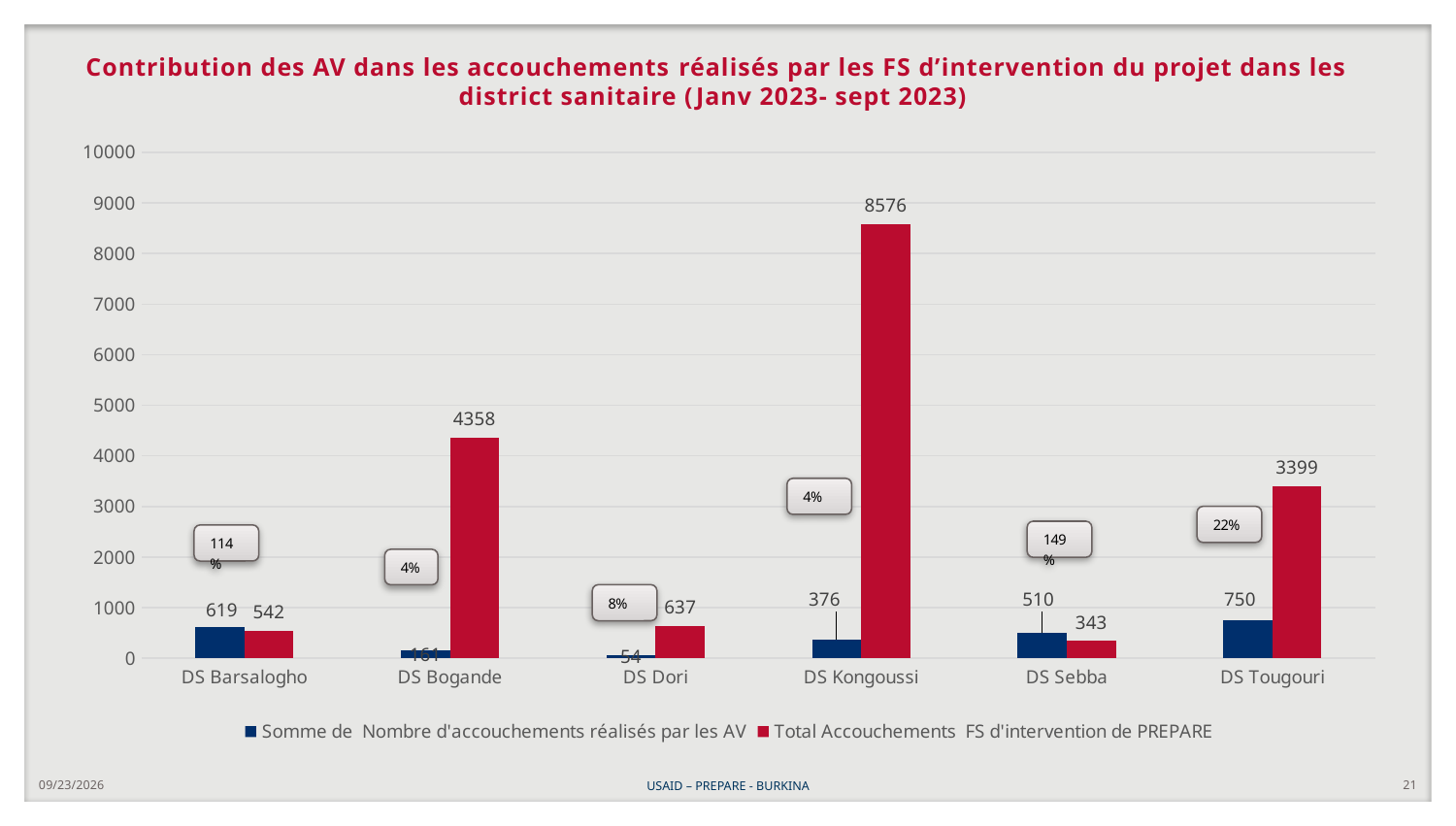
For DS Barsalogho, which is larger: accouchements réalisés par les AV or Total Accouchements? Accouchements réalisés par les AV What is the difference between Total Accouchements and accouchements réalisés par les AV for DS Kongoussi? 8200 Which district has the lowest value for Somme de Nombre d'accouchements réalisés par les AV? DS Dori What is the value of Total Accouchements FS d'intervention de PREPARE for DS Kongoussi? 8576 What is the value of Total Accouchements FS d'intervention de PREPARE for DS Sebba? 343 Is the Total Accouchements value for DS Bogande greater or less than 4000? greater How many series does the legend list? 2 What is the value of Somme de Nombre d'accouchements réalisés par les AV for DS Tougouri? 750 What is the difference between Total Accouchements and accouchements réalisés par les AV for DS Tougouri? 2649 Which district has the highest value for Total Accouchements FS d'intervention de PREPARE? DS Kongoussi What kind of chart is shown on the slide? Bar chart How many districts are shown on the x axis? 6